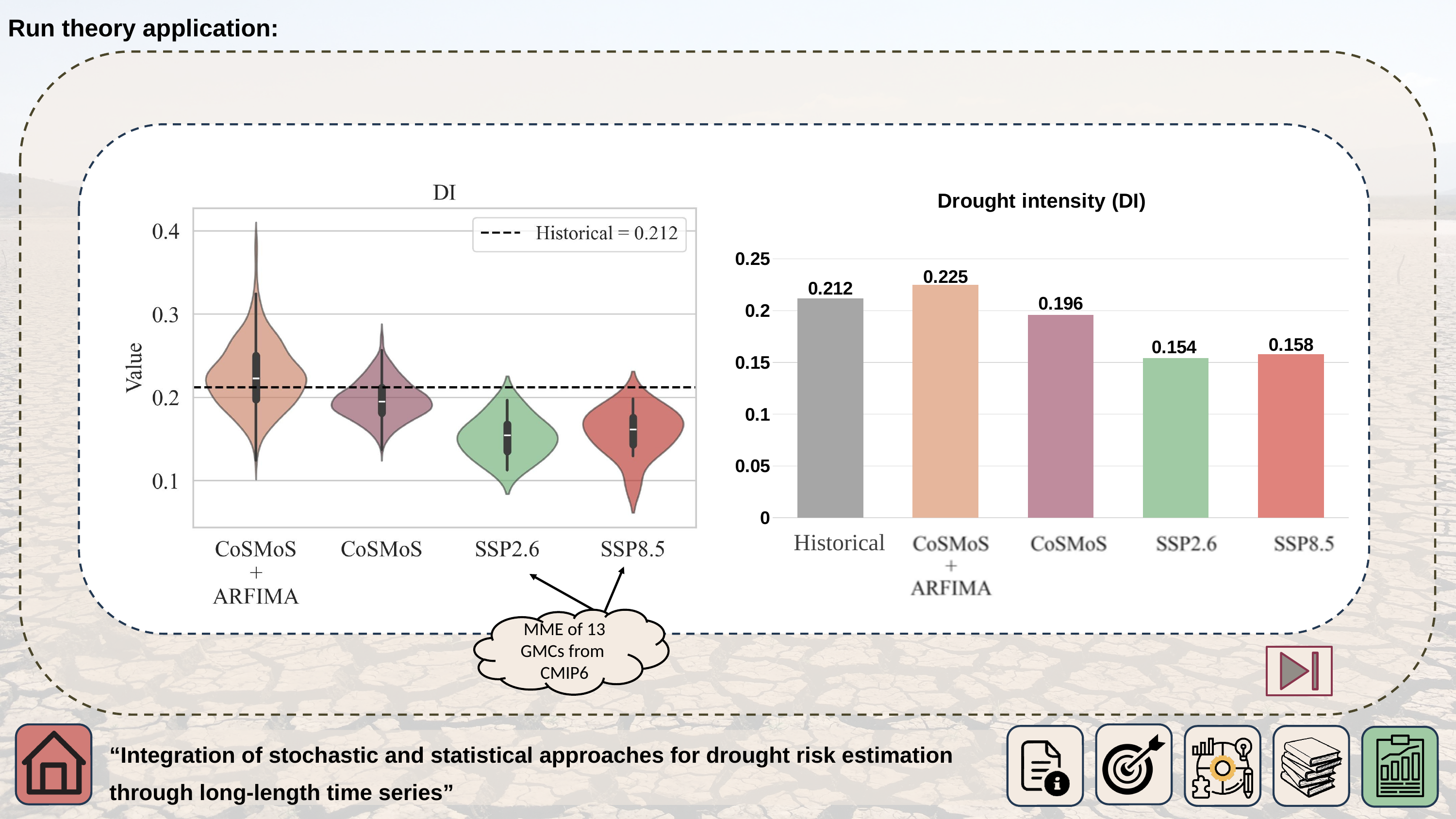
In the 'Drought intensity (DI)' bar chart, which is larger, the value for SSP8.5 or the value for SSP2.6? SSP8.5 In the violin plot titled 'DI' on the left, what value does the legend give for the dashed Historical line? 0.212 How many bars are in the 'Drought intensity (DI)' bar chart? 5 In the 'Drought intensity (DI)' bar chart, which category has the highest value? CoSMoS + ARFIMA In the 'Drought intensity (DI)' bar chart, what is the difference between the CoSMoS + ARFIMA value and the CoSMoS value? 0.029 In the 'Drought intensity (DI)' bar chart, what is the value for SSP2.6? 0.154 In the 'Drought intensity (DI)' bar chart, what is the value for Historical? 0.212 What kind of chart is the chart titled 'Drought intensity (DI)'? bar chart In the 'Drought intensity (DI)' bar chart, which category has the lowest value? SSP2.6 In the 'Drought intensity (DI)' bar chart, what is the value for CoSMoS + ARFIMA? 0.225 In the 'Drought intensity (DI)' bar chart, is the value for CoSMoS greater or less than 0.2? less How many categories are shown on the x axis of the violin plot titled 'DI' on the left? 4